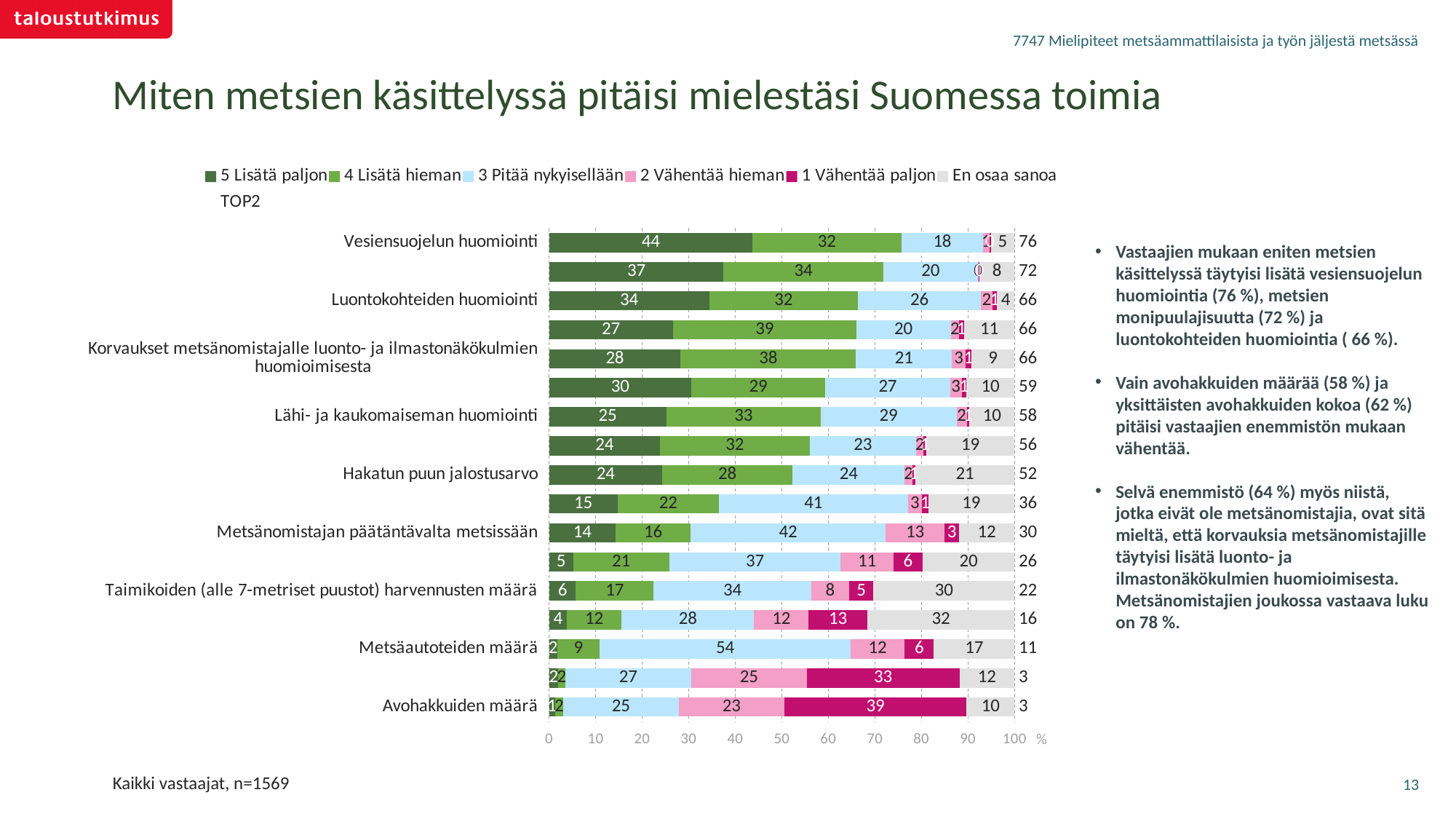
What is the value of "3 Pitää nykyisellään" for Metsäautoteiden määrä? 54 What is the value of "1 Vähentää paljon" for Avohakkuiden määrä? 39 What kind of chart is shown on the slide? Stacked bar chart Which category has the highest TOP2 value? Vesiensuojelun huomiointi For Hakatun puun jalostusarvo, which is larger: "5 Lisätä paljon" or "4 Lisätä hieman"? 4 Lisätä hieman What is the value of "2 Vähentää hieman" for Metsänomistajan päätäntävalta metsissään? 13 What is the "En osaa sanoa" value for Taimikoiden (alle 7-metriset puustot) harvennusten määrä? 30 What is the value of "5 Lisätä paljon" for Vesiensuojelun huomiointi? 44 What is the TOP2 value shown for Luontokohteiden huomiointi? 66 What is the title of the chart on the slide? Miten metsien käsittelyssä pitäisi mielestäsi Suomessa toimia What is the difference between the "5 Lisätä paljon" and "4 Lisätä hieman" values for Vesiensuojelun huomiointi? 12